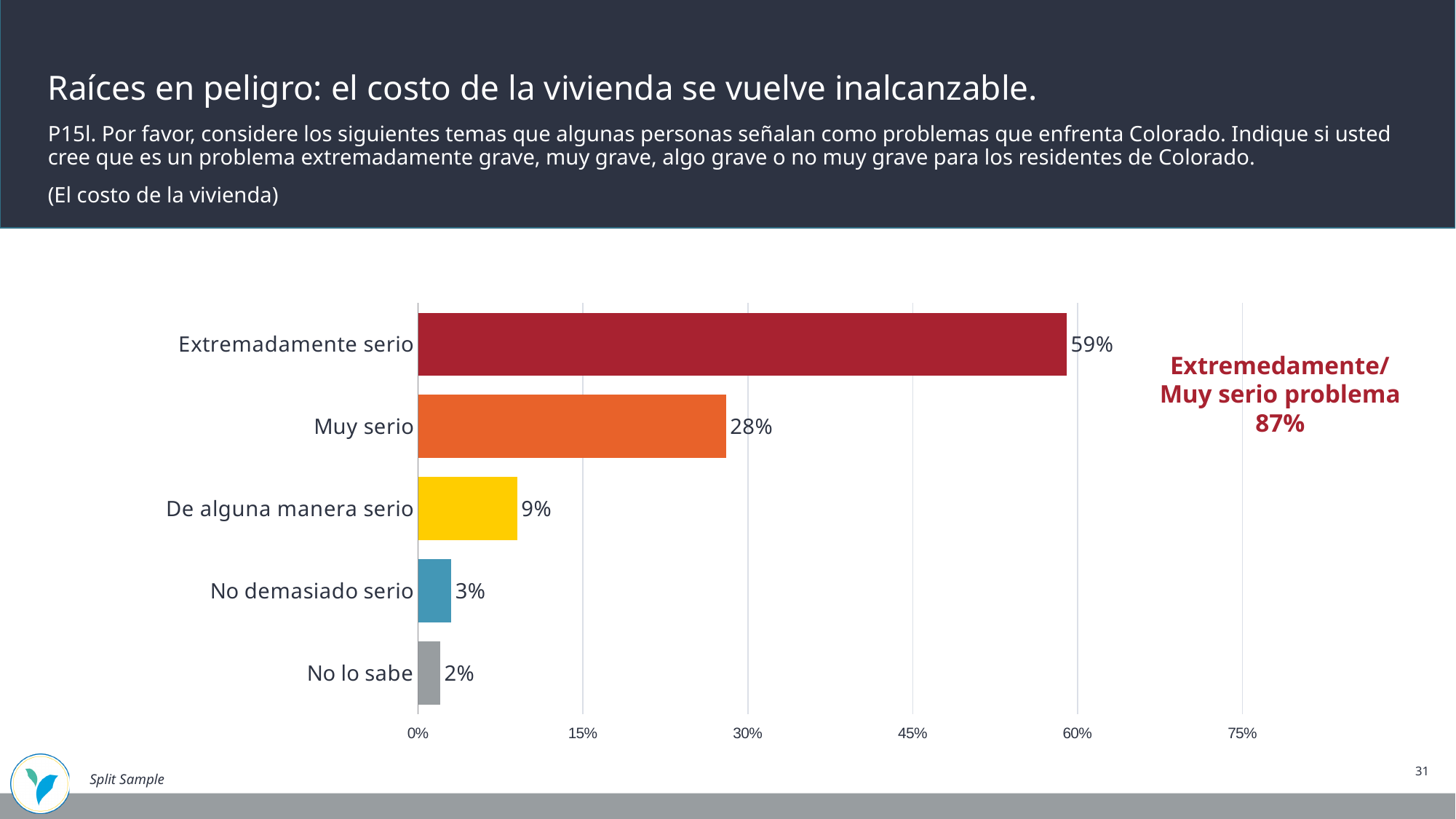
What is the difference between the values for "Extremadamente serio" and "Muy serio"? 31% Which category has the highest value? Extremadamente serio How many categories are shown in the chart? 5 Which category has the lowest value? No lo sabe Is the value for "Muy serio" greater or less than 30%? less What kind of chart is shown on the slide? bar chart Which is larger, the value for "De alguna manera serio" or "No demasiado serio"? De alguna manera serio What combined percentage is given in the red annotation for "Extremedamente/Muy serio problema"? 87% What is the value for "De alguna manera serio"? 9% What is the value for "Extremadamente serio"? 59% What is the value for "No lo sabe"? 2% What is the value for "Muy serio"? 28%